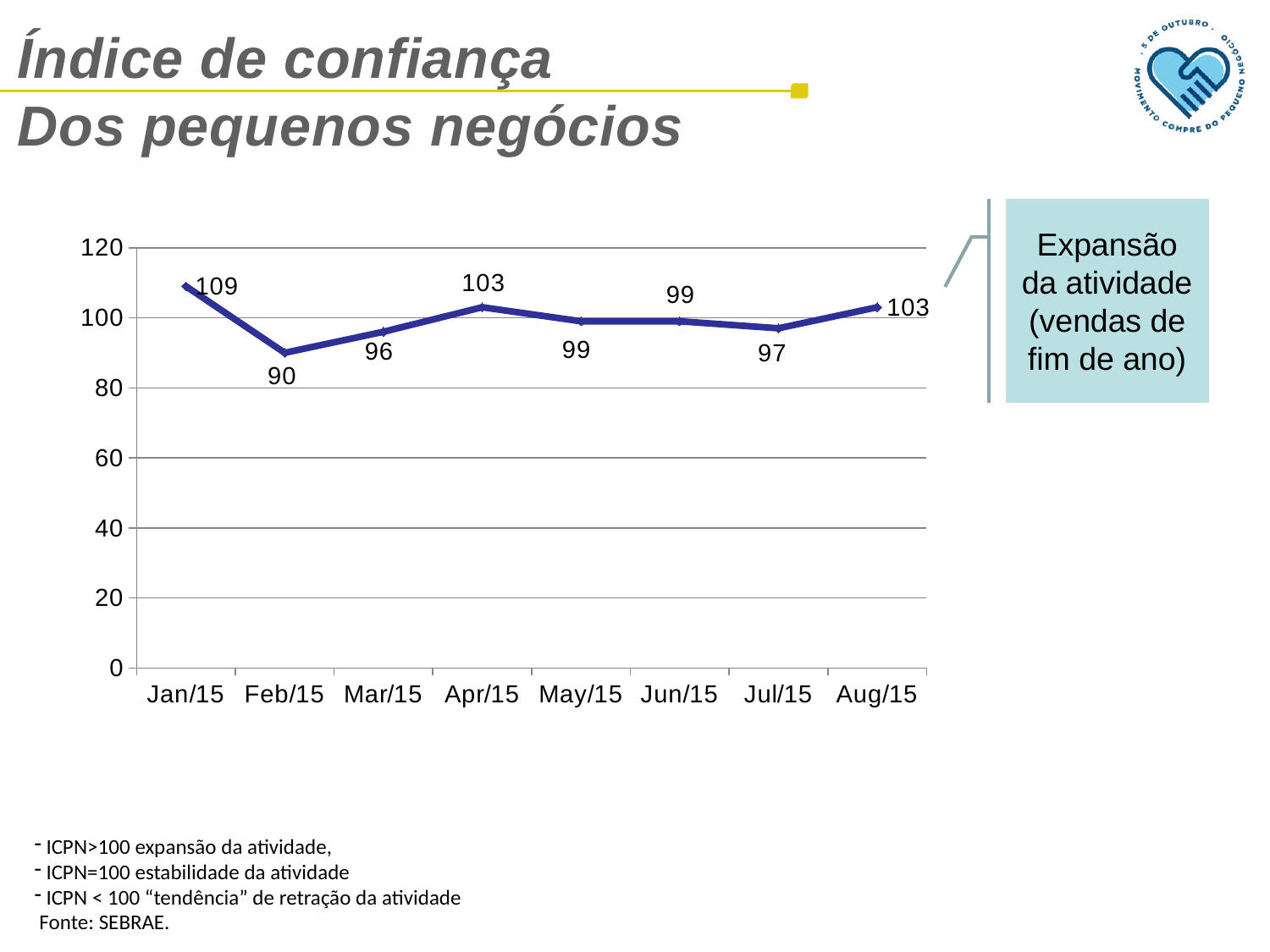
What is the difference between the values for Jan/15 and Feb/15? 19 What is the value for Jul/15? 97 What is the value for Feb/15? 90 Which is larger, the value for Mar/15 or the value for Jul/15? Jul/15 What is the value for Jan/15? 109 What kind of chart is shown on the slide? line chart Which month has the lowest value? Feb/15 Which month has the highest value? Jan/15 How many months are plotted on the chart? 8 Is the value for Feb/15 greater or less than 100? less Does the value rise or fall from Jul/15 to Aug/15? rise What is the value for Aug/15? 103